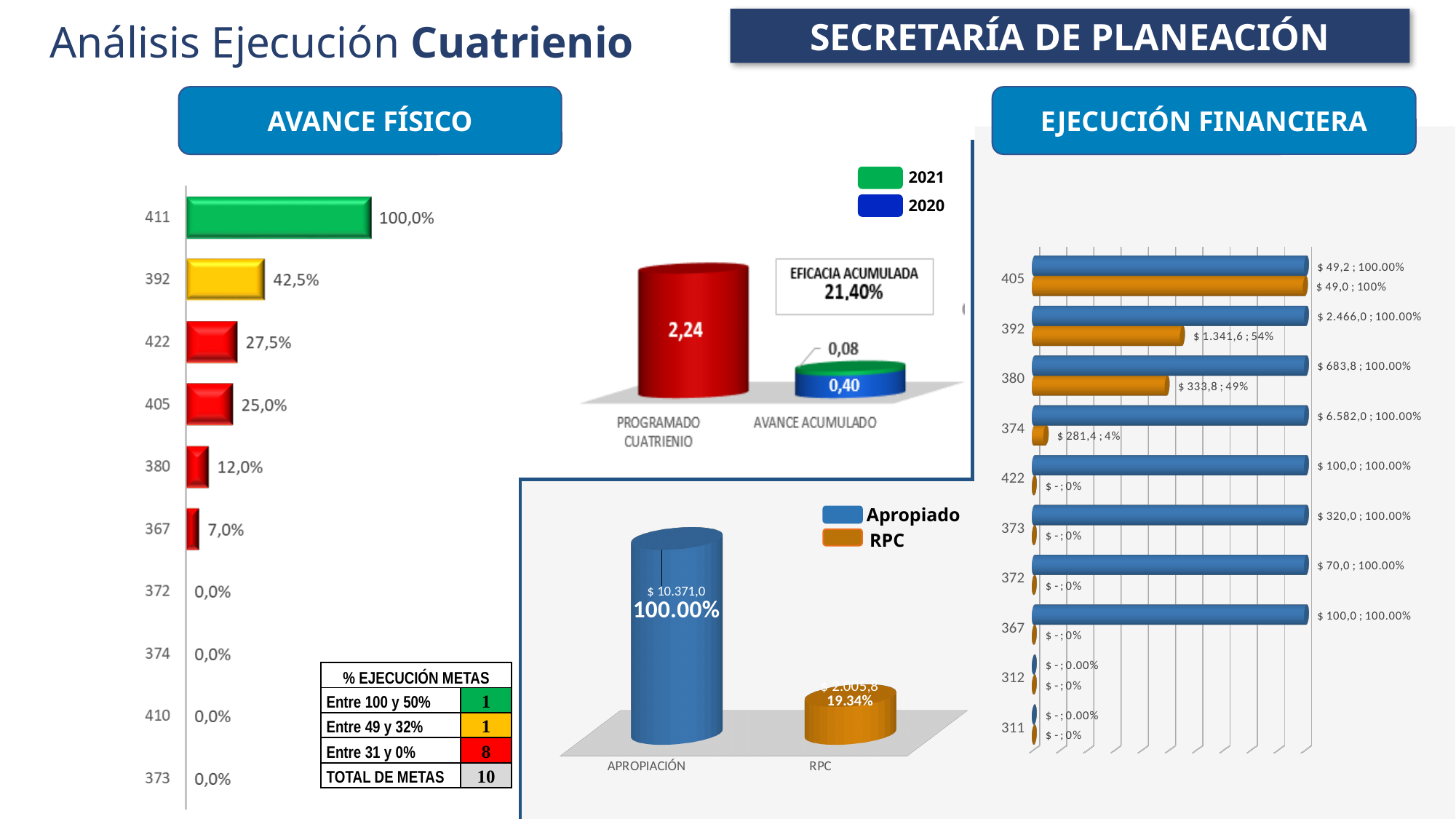
In the APROPIACIÓN / RPC chart in the bottom middle, what percentage is shown for RPC? 19.34% In the PROGRAMADO CUATRIENIO / AVANCE ACUMULADO chart in the top middle, how many series does the legend list? 2 In the EJECUCIÓN FINANCIERA bar chart on the right, what kind of chart is it? bar chart In the APROPIACIÓN / RPC chart in the bottom middle, what value is shown for APROPIACIÓN? $ 10.371,0 In the AVANCE FÍSICO bar chart on the left, what is the difference between the values for 422 and 405? 2,5% In the AVANCE FÍSICO bar chart on the left, how many categories are shown? 10 In the PROGRAMADO CUATRIENIO / AVANCE ACUMULADO chart in the top middle, what is the value for PROGRAMADO CUATRIENIO? 2,24 In the AVANCE FÍSICO bar chart on the left, what is the value for category 411? 100,0% In the AVANCE FÍSICO bar chart on the left, which category has the highest value? 411 In the AVANCE FÍSICO bar chart on the left, which is larger, the value for 380 or the value for 367? 380 In the EJECUCIÓN FINANCIERA bar chart on the right, what is the RPC value for category 392? $ 1.341,6 ; 54% In the AVANCE FÍSICO bar chart on the left, what is the value for category 392? 42,5%